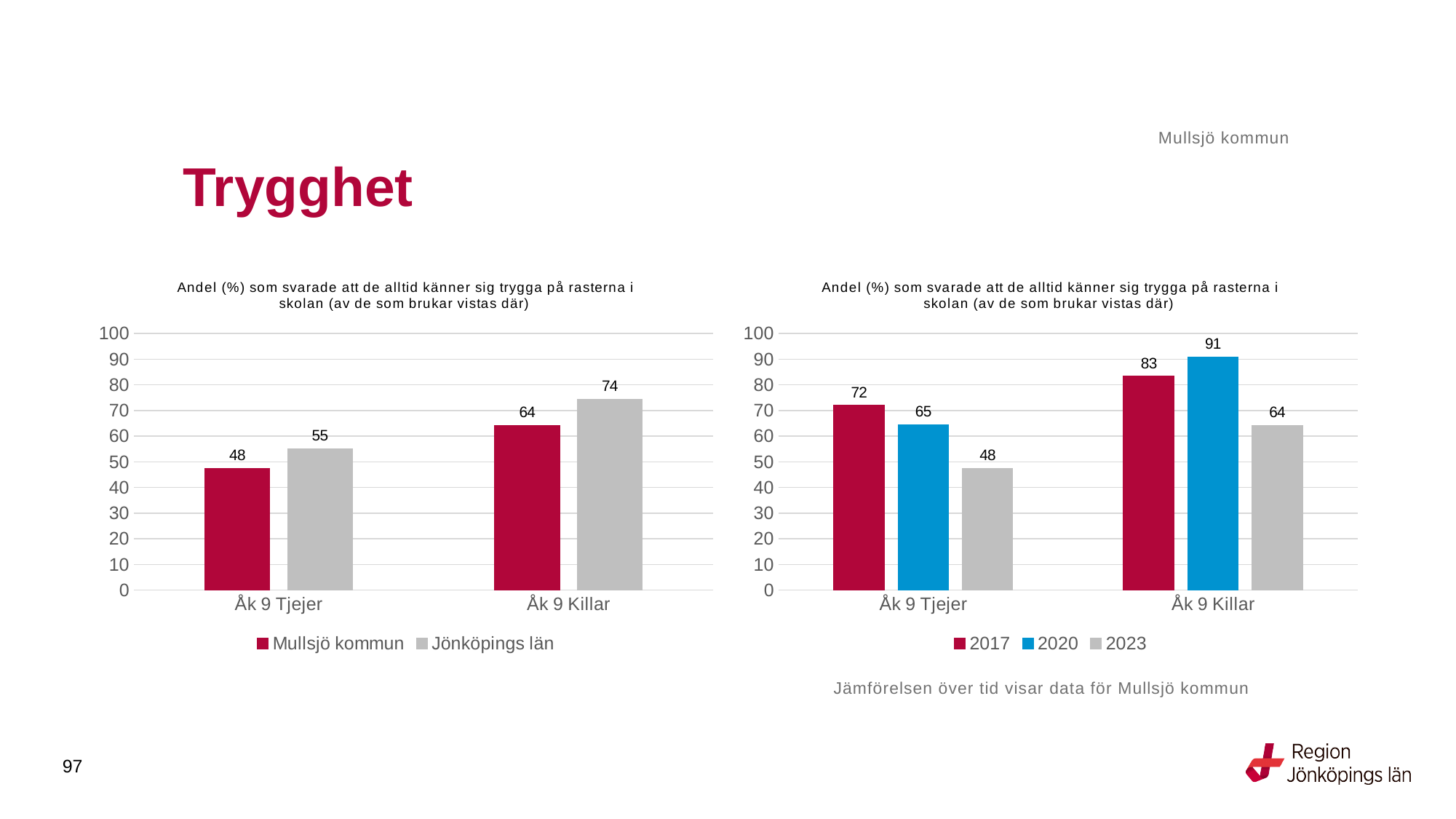
How many series does the legend of the right chart list? 3 In the left chart, what is the value for Mullsjö kommun for Åk 9 Tjejer? 48 In the left chart, what is the difference between Jönköpings län and Mullsjö kommun for Åk 9 Tjejer? 7 In the right chart, which year has the lowest value for Åk 9 Tjejer? 2023 In the right chart, do the values for Åk 9 Tjejer rise or fall from 2017 to 2023? fall How many series does the legend of the left chart list? 2 In the left chart, what is the value for Jönköpings län for Åk 9 Killar? 74 In the right chart, what is the difference between 2017 and 2023 for Åk 9 Killar? 19 In the left chart, which is larger for Åk 9 Killar: Mullsjö kommun or Jönköpings län? Jönköpings län In the right chart, what is the value for 2023 for Åk 9 Tjejer? 48 What kind of chart is the right chart? bar chart In the right chart, what is the value for 2020 for Åk 9 Killar? 91